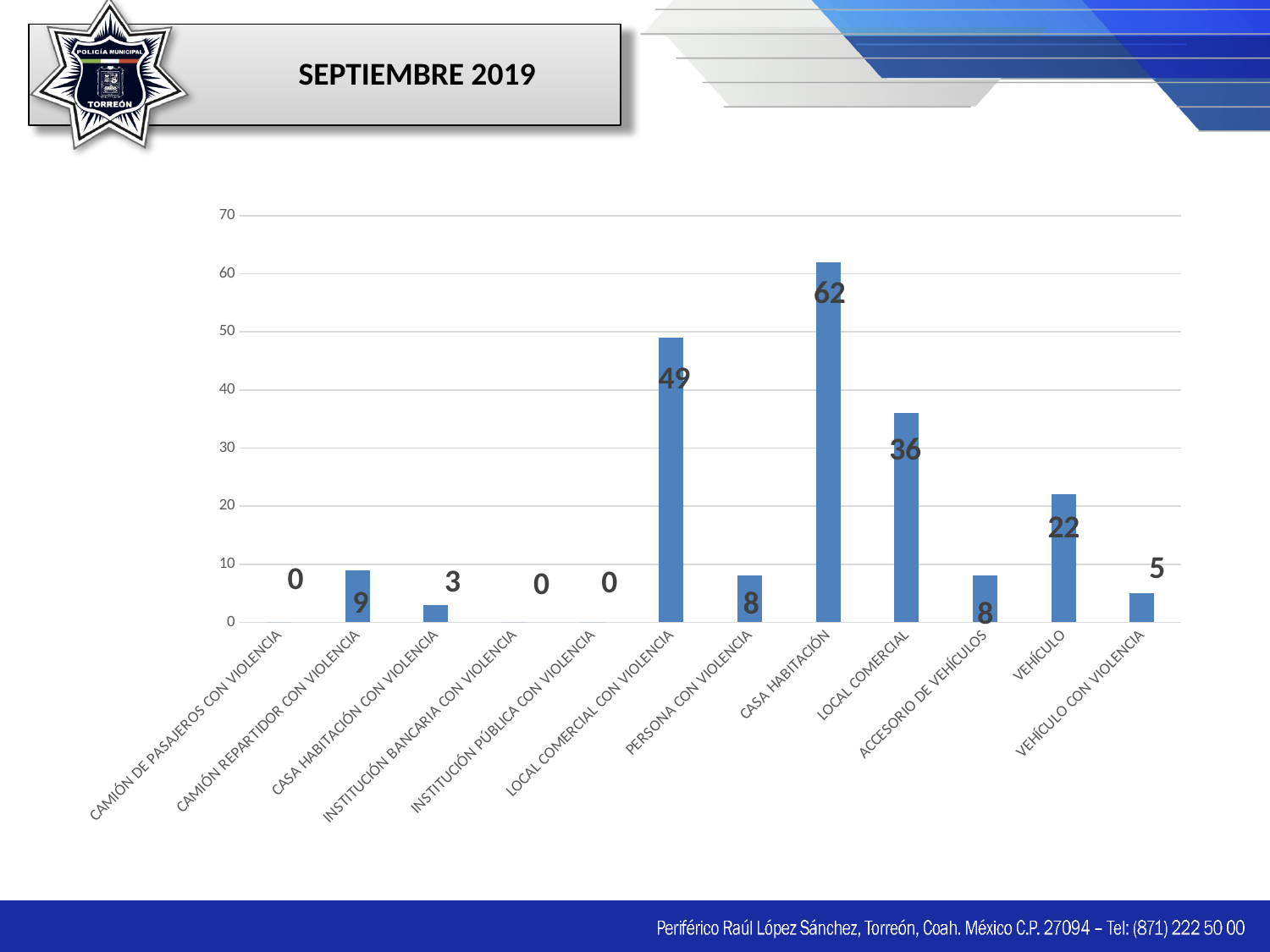
What kind of chart is shown on the slide? bar chart What is the value for CAMIÓN REPARTIDOR CON VIOLENCIA? 9 What is the value for VEHÍCULO? 22 What is the difference between the values for CASA HABITACIÓN and LOCAL COMERCIAL? 26 What is the value for LOCAL COMERCIAL CON VIOLENCIA? 49 Which category has the highest value? CASA HABITACIÓN How many categories are shown on the x axis? 12 What is the value for CASA HABITACIÓN? 62 Is the value for VEHÍCULO greater or less than 30? less What is the title shown in the header box above the chart? SEPTIEMBRE 2019 Which is larger, the value for LOCAL COMERCIAL CON VIOLENCIA or the value for LOCAL COMERCIAL? LOCAL COMERCIAL CON VIOLENCIA How many categories have a value of 0? 3